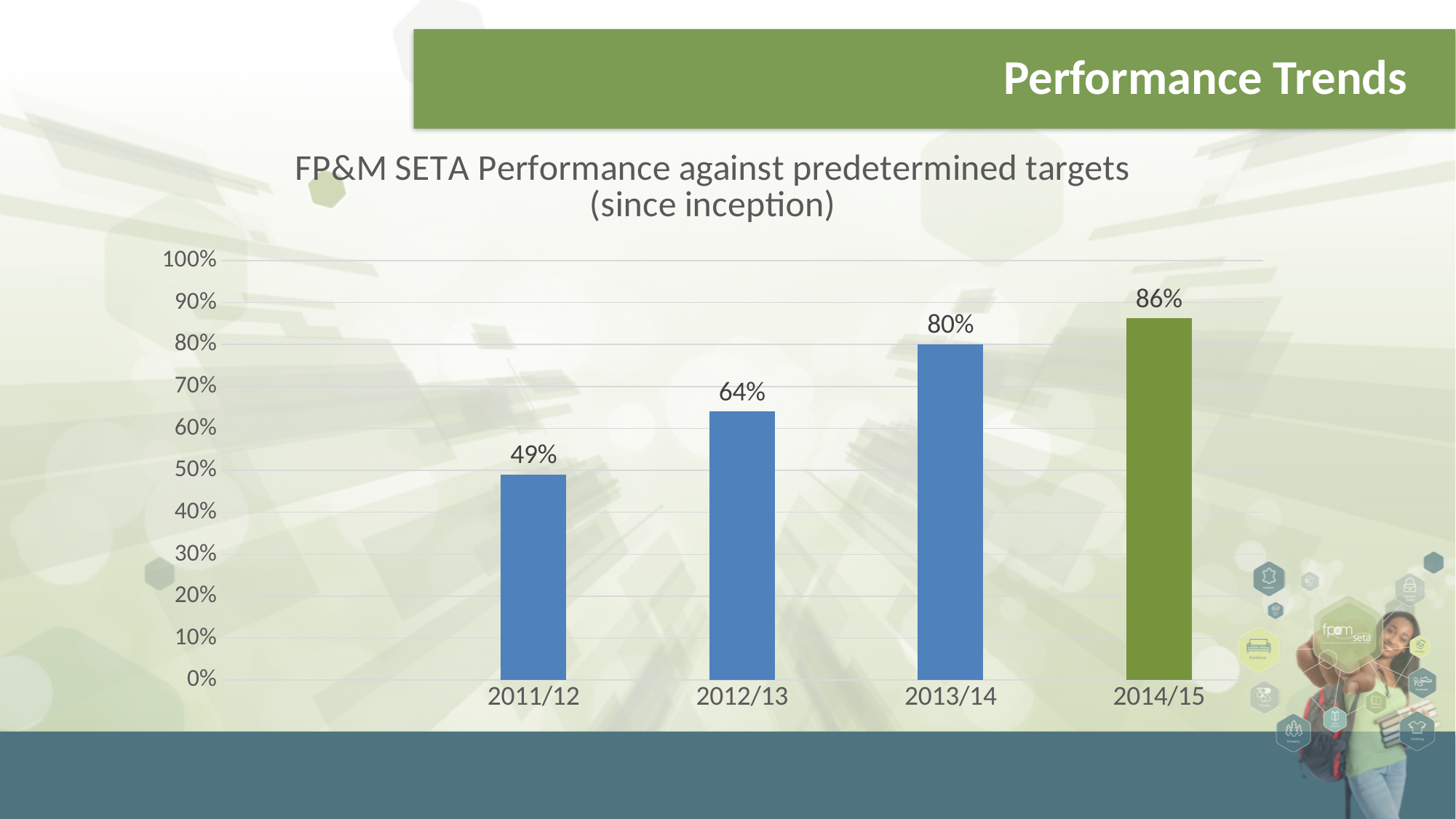
What is the value for 2013/14? 80% Which year has the lowest performance value? 2011/12 What is the value for 2014/15? 86% What is the value for 2012/13? 64% What is the difference between the values for 2014/15 and 2011/12? 37% What is the value for 2011/12? 49% What kind of chart is shown on the slide? Bar chart How many years are shown on the x axis? 4 Which year has the highest performance value? 2014/15 Do the values rise or fall from 2011/12 to 2014/15? Rise Which is larger, the value for 2012/13 or the value for 2013/14? 2013/14 What is the difference between the values for 2013/14 and 2012/13? 16%